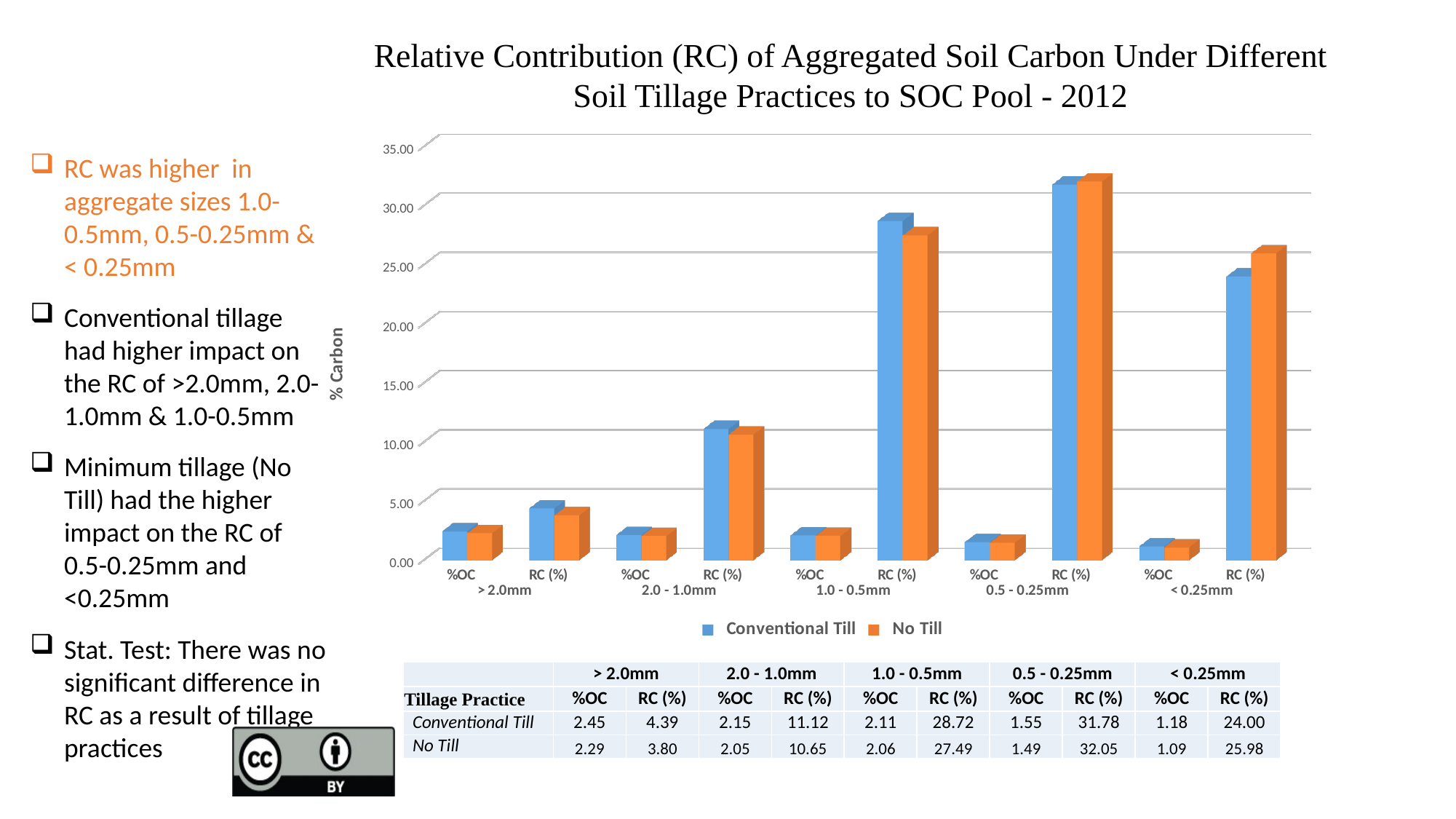
What is the RC (%) value for Conventional Till in the 1.0 - 0.5mm aggregate size? 28.72 What is the label of the vertical axis of the chart? % Carbon What is the lowest value in the No Till series? 1.09 How many series does the chart legend list? 2 What kind of chart is shown on the slide? bar chart For which aggregate size and measure does the Conventional Till series reach its highest value? RC (%) for 0.5 - 0.25mm How many categories are shown along the x axis of the chart? 10 What is the %OC value for No Till in the > 2.0mm aggregate size? 2.29 What is the difference between the Conventional Till and No Till RC (%) values for the 1.0 - 0.5mm aggregate size? 1.23 Is the Conventional Till RC (%) value for the 2.0 - 1.0mm aggregate size greater or less than 10.00? greater What is the RC (%) value for No Till in the < 0.25mm aggregate size? 25.98 Which series has the larger RC (%) value for the < 0.25mm aggregate size, Conventional Till or No Till? No Till